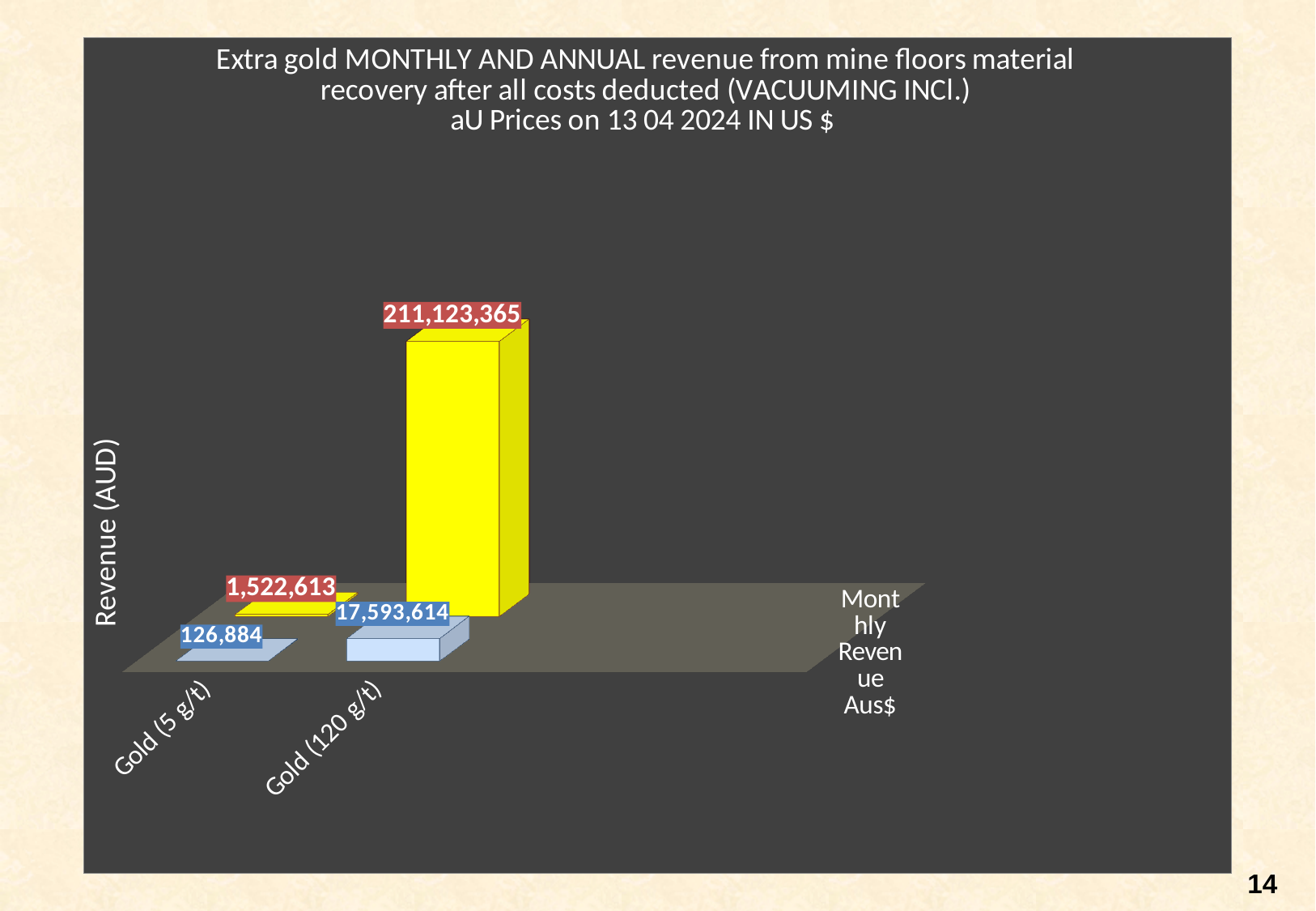
How many gold grade categories are shown on the x axis? 2 Which is larger: the Monthly Revenue Aus$ for Gold (120 g/t) or the yellow (annual) bar for Gold (5 g/t)? Monthly Revenue Aus$ for Gold (120 g/t) What is the label on the vertical axis of the chart? Revenue (AUD) What is the Monthly Revenue Aus$ value for Gold (120 g/t)? 17,593,614 Which bar has the lowest value on the chart? Gold (5 g/t) monthly, 126,884 Which bar has the highest value on the chart? Gold (120 g/t) annual, 211,123,365 What value is labelled on the yellow (annual) bar for Gold (120 g/t)? 211,123,365 What is the difference between the yellow (annual) bar values for Gold (120 g/t) and Gold (5 g/t)? 209,600,752 What type of chart is shown on the slide? Bar chart What is the difference between the Monthly Revenue Aus$ values for Gold (120 g/t) and Gold (5 g/t)? 17,466,730 What value is labelled on the yellow (annual) bar for Gold (5 g/t)? 1,522,613 What is the Monthly Revenue Aus$ value for Gold (5 g/t)? 126,884